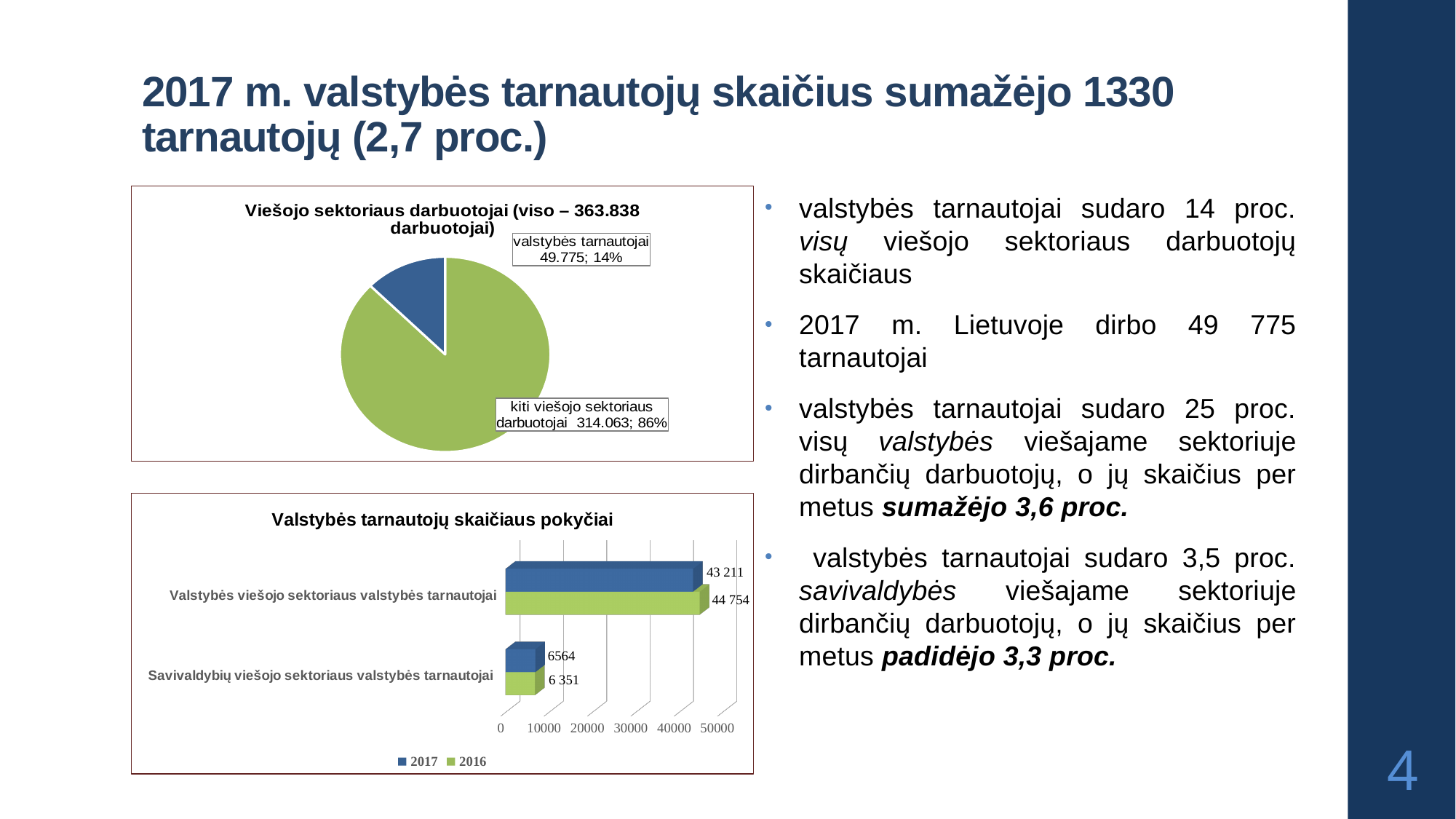
In the bar chart 'Valstybės tarnautojų skaičiaus pokyčiai', what is the 2017 value for Valstybės viešojo sektoriaus valstybės tarnautojai? 43 211 In the pie chart 'Viešojo sektoriaus darbuotojai', what share of the pie is kiti viešojo sektoriaus darbuotojai? 86% How many series does the legend of the bar chart 'Valstybės tarnautojų skaičiaus pokyčiai' list? 2 In the bar chart 'Valstybės tarnautojų skaičiaus pokyčiai', which is larger for Savivaldybių viešojo sektoriaus valstybės tarnautojai: the 2017 value or the 2016 value? 2017 What type of chart is the bottom chart 'Valstybės tarnautojų skaičiaus pokyčiai'? bar chart How many categories are shown in the bar chart 'Valstybės tarnautojų skaičiaus pokyčiai'? 2 In the bar chart 'Valstybės tarnautojų skaičiaus pokyčiai', what is the difference between the 2016 and 2017 values for Valstybės viešojo sektoriaus valstybės tarnautojai? 1 543 In the pie chart 'Viešojo sektoriaus darbuotojai', what share of the pie is valstybės tarnautojai? 14% What type of chart is the top chart 'Viešojo sektoriaus darbuotojai'? pie chart In the bar chart 'Valstybės tarnautojų skaičiaus pokyčiai', what is the 2016 value for Savivaldybių viešojo sektoriaus valstybės tarnautojai? 6 351 In the pie chart 'Viešojo sektoriaus darbuotojai', which slice is the largest? kiti viešojo sektoriaus darbuotojai In the pie chart 'Viešojo sektoriaus darbuotojai', what value is shown for valstybės tarnautojai? 49.775